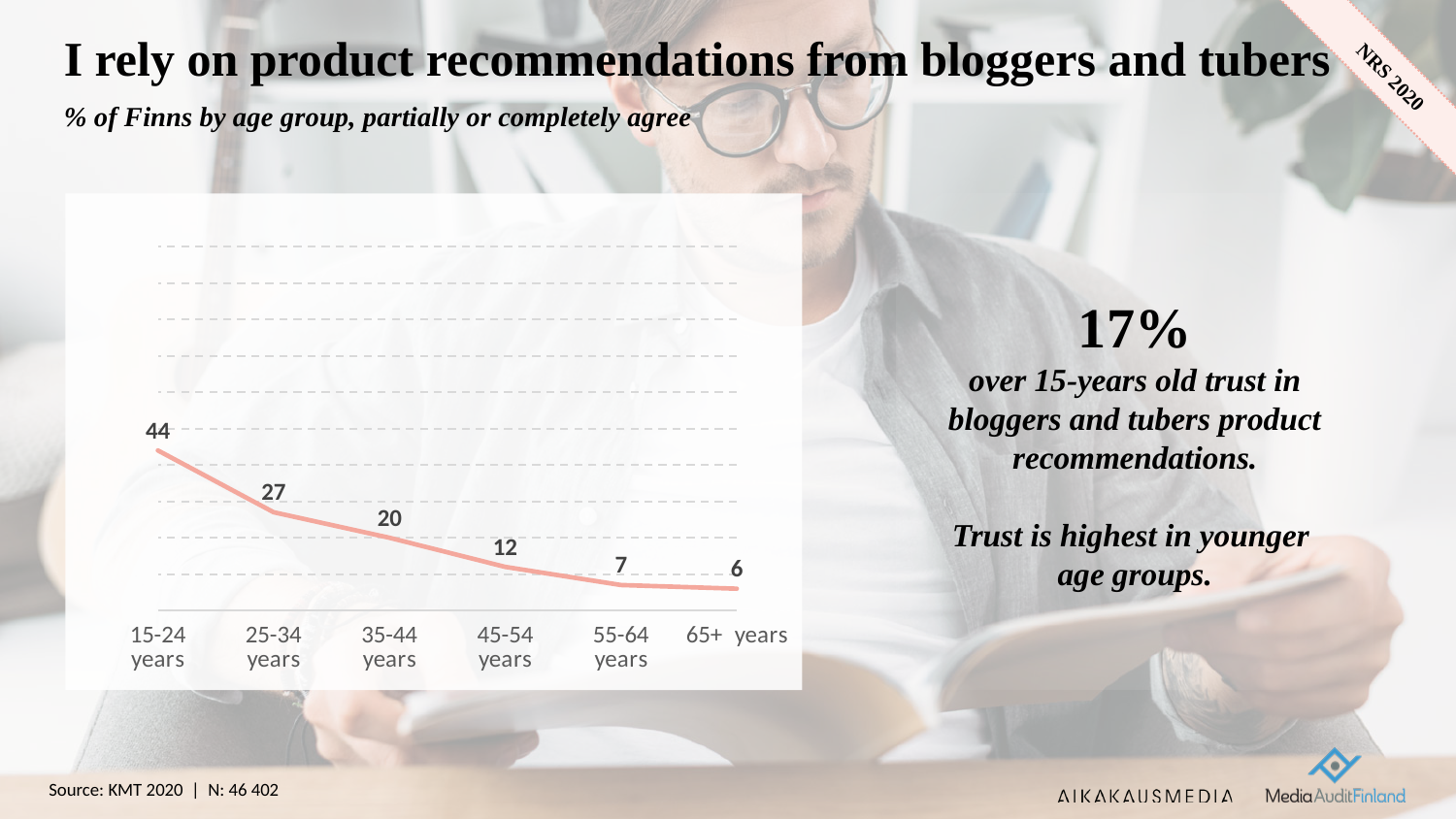
Which is larger, the value for 25-34 years or the value for 45-54 years? 25-34 years How many age groups are plotted on the chart? 6 What kind of chart is shown on the slide? line chart What is the value for the 15-24 years age group? 44 What is the title of the chart on the slide? I rely on product recommendations from bloggers and tubers What is the value for the 35-44 years age group? 20 What is the value for the 55-64 years age group? 7 What is the difference between the values for 45-54 years and 65+ years? 6 Do the values rise or fall as age group increases along the x axis? fall Which age group has the lowest value? 65+ years Which age group has the highest value? 15-24 years What is the difference between the values for 15-24 years and 25-34 years? 17